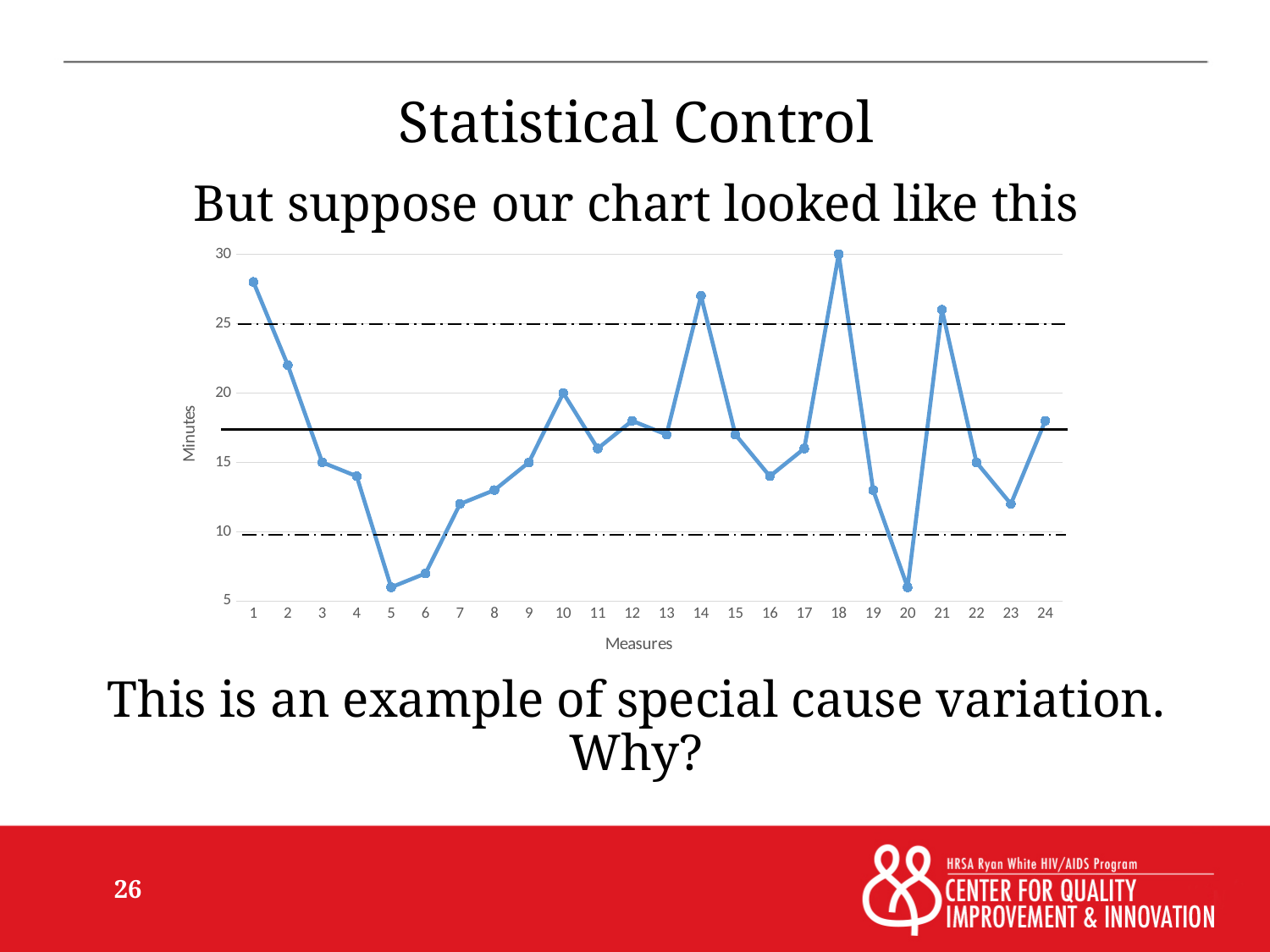
What kind of chart is shown on the slide? line chart Which has the larger value, measure 1 or measure 2? measure 1 Is the value for measure 20 greater or less than 10? less What is the value in minutes at measure 18? 30 Do the values rise or fall from measure 1 to measure 5? fall What is the value in minutes at measure 10? 20 How many measures (data points) are plotted on the chart? 24 Is the value for measure 14 greater or less than 25? greater Is the value for measure 5 greater or less than 10? less At which measure does the line reach its highest value? 18 What is the label on the vertical axis of the chart? Minutes